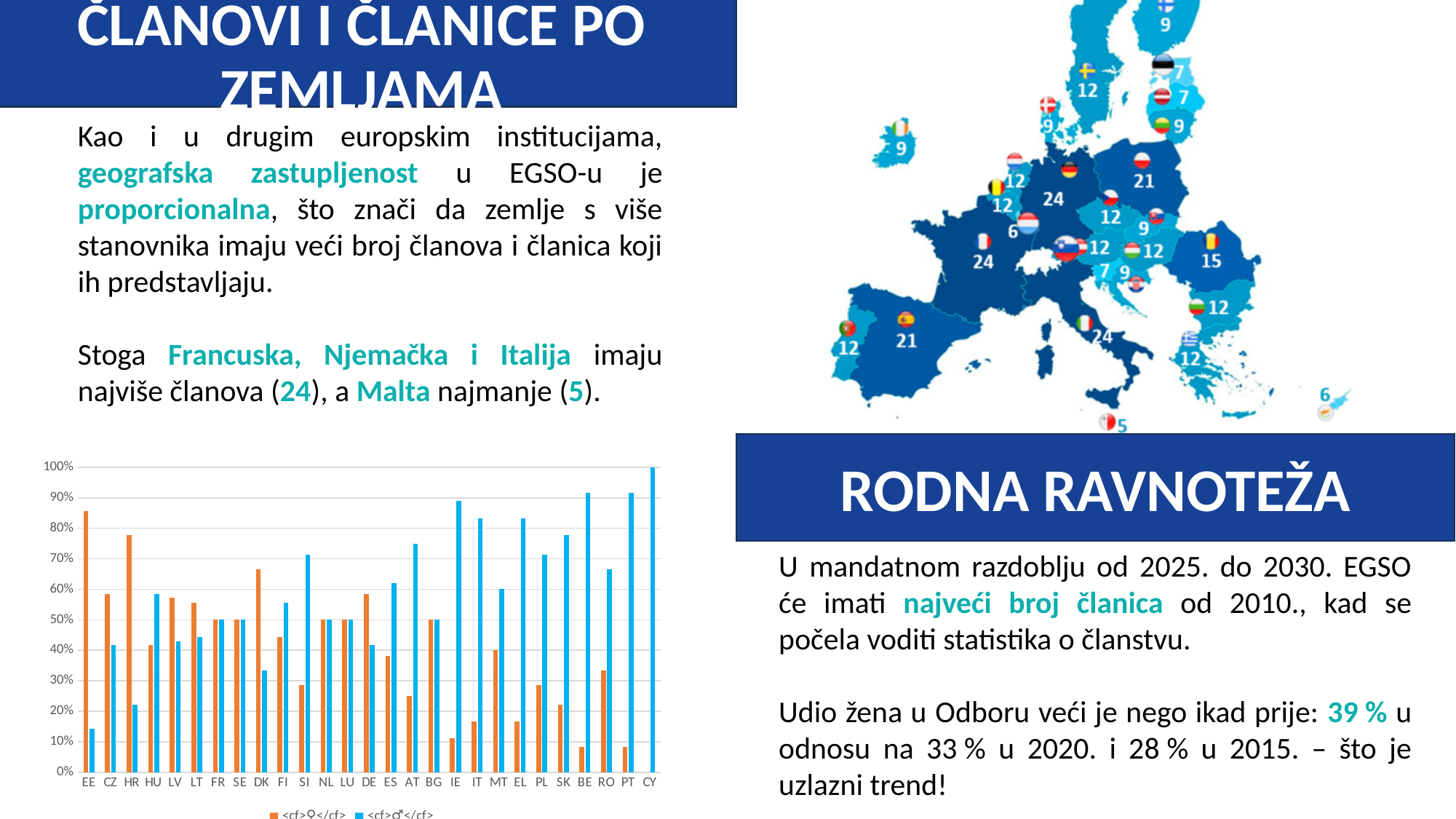
In the bar chart, which country has the highest orange (♀) bar? EE In the bar chart, is the orange (♀) value for DK greater or less than 60%? greater In the bar chart, which country has the highest blue (♂) bar? CY How many series does the legend of the bar chart list? 2 In the bar chart, what is the value of the orange (♀) bar for FR? 50% What kind of chart is shown at the bottom left of the slide? bar chart In the bar chart, is the blue (♂) value for IE greater or less than 80%? greater In the bar chart, what is the value of the blue (♂) bar for CY? 100% In the bar chart, which colour represents the ♀ series? orange In the bar chart, which country has the lowest blue (♂) bar? EE How many country categories are shown on the x axis of the bar chart? 27 In the bar chart, for HR, which bar is larger: the orange (♀) or the blue (♂)? orange (♀)